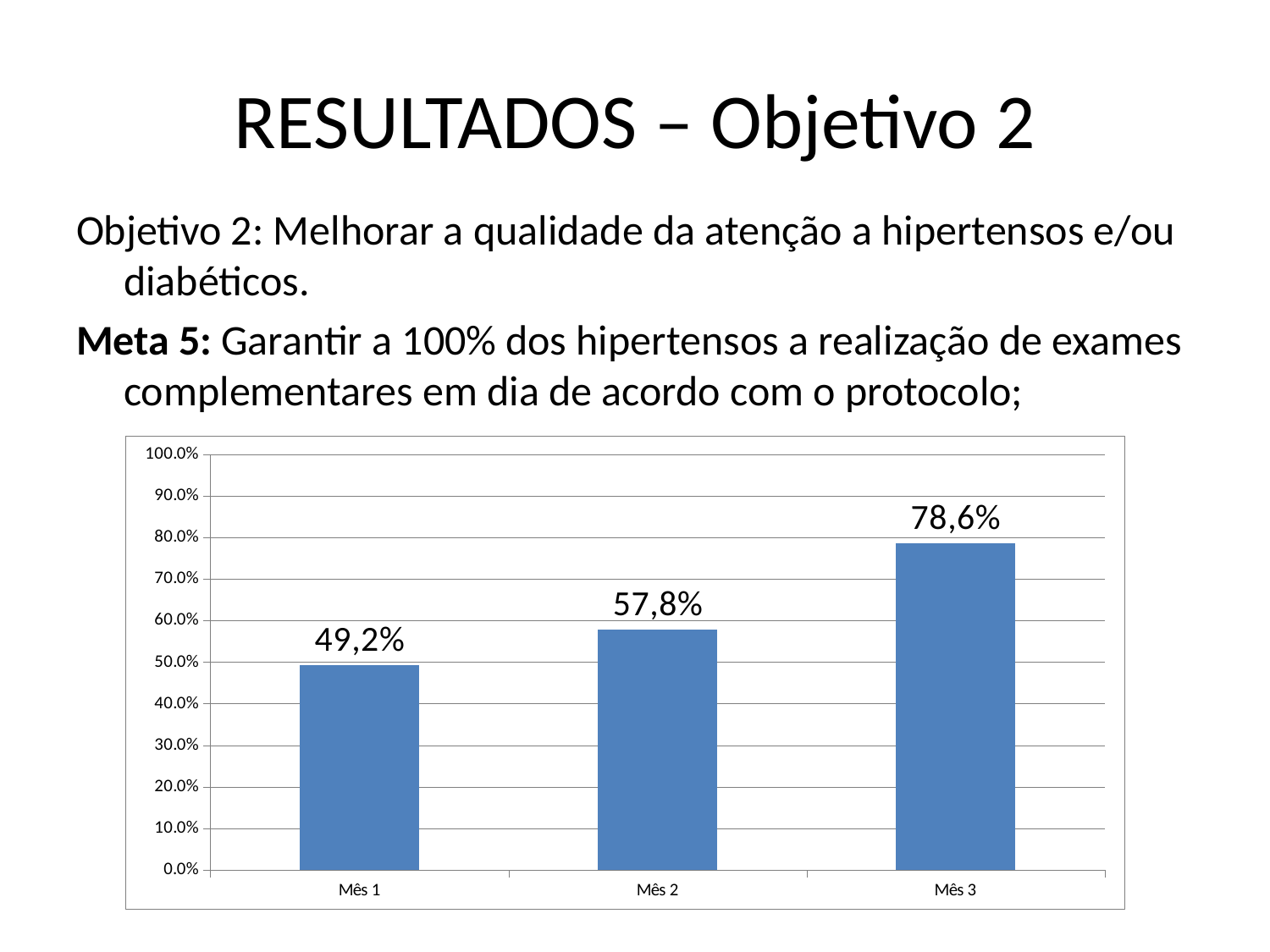
What is the difference between the values for Mês 3 and Mês 1? 29,4% Which month has the lowest value? Mês 1 What is the difference between the values for Mês 2 and Mês 1? 8,6% Is the value for Mês 1 greater or less than 50.0%? less What kind of chart is shown on the slide? bar chart What is the value for Mês 3? 78,6% What is the value for Mês 1? 49,2% Which month has the highest value? Mês 3 Do the values rise or fall from Mês 1 to Mês 3? rise Which is larger, the value for Mês 2 or the value for Mês 3? Mês 3 What is the value for Mês 2? 57,8% How many months are shown on the x axis? 3